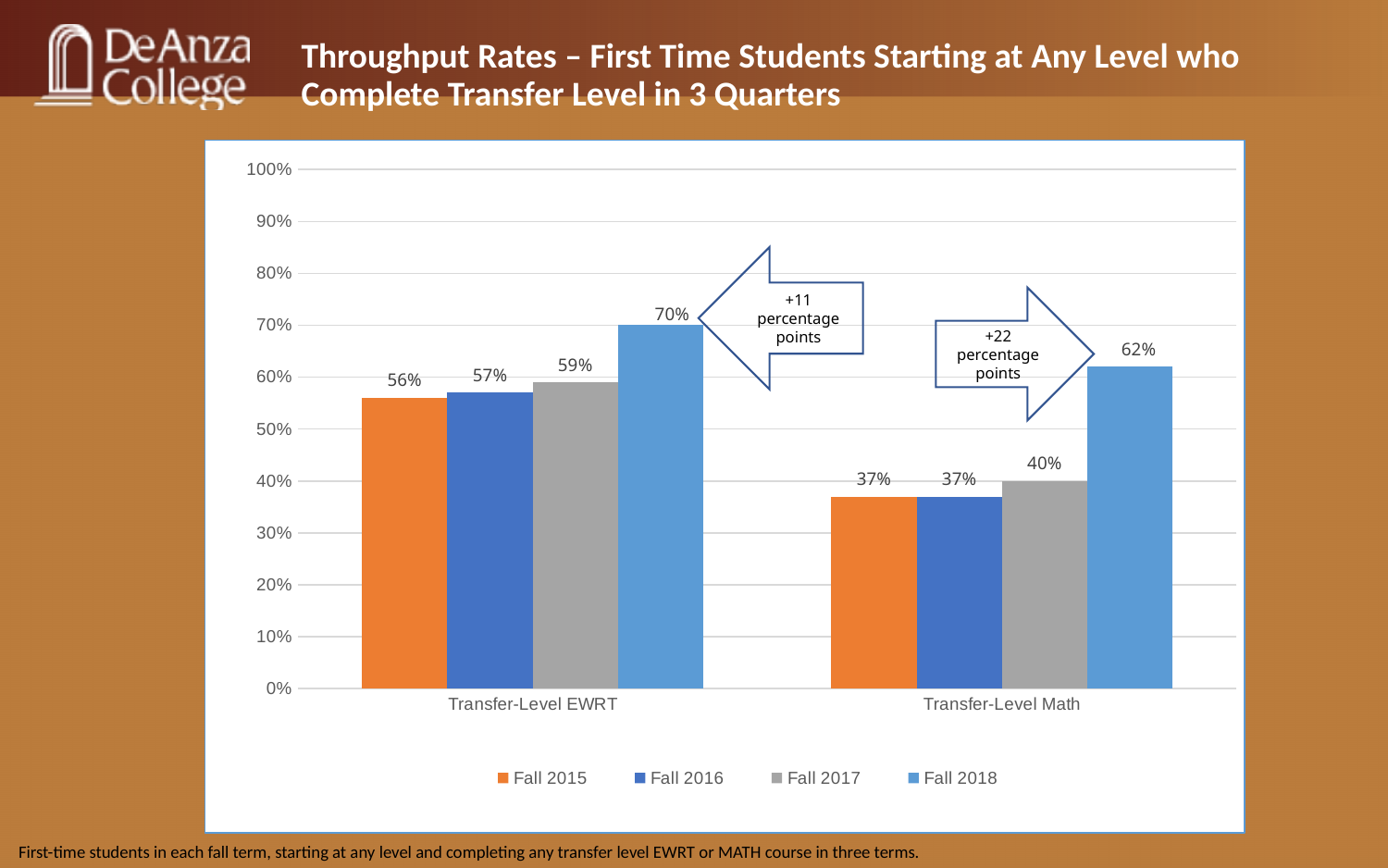
What is the Fall 2017 value for Transfer-Level Math? 40% What kind of chart is shown on the slide? Bar chart Which series has the lowest value for Transfer-Level EWRT? Fall 2015 Do the Transfer-Level Math values rise or fall from Fall 2015 to Fall 2018? Rise What is the Fall 2015 value for Transfer-Level Math? 37% Which is larger, the Fall 2018 value for Transfer-Level EWRT or the Fall 2018 value for Transfer-Level Math? Transfer-Level EWRT What is the Fall 2018 value for Transfer-Level EWRT? 70% Which series has the highest value for Transfer-Level EWRT? Fall 2018 What is the difference between the Fall 2018 and Fall 2015 values for Transfer-Level Math? 25 percentage points What is the difference between the Fall 2018 and Fall 2017 values for Transfer-Level EWRT? 11 percentage points How many categories are shown on the x axis? 2 How many series does the legend list? 4